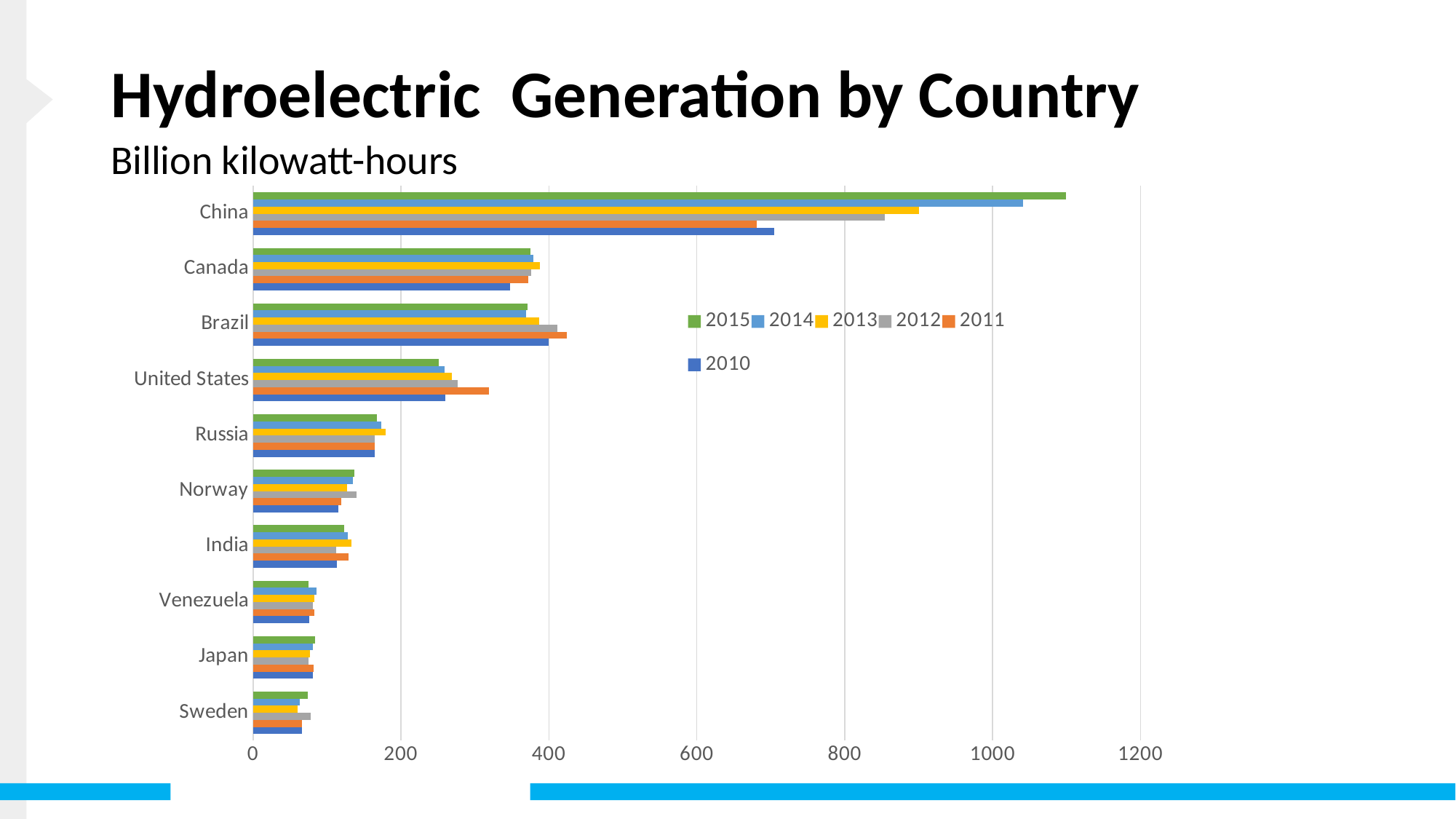
Is the value for Canada in 2015 greater or less than 400? less Which country has the highest hydroelectric generation in 2015? China How many countries are shown on the chart? 10 What kind of chart is shown on the slide? Bar chart How many series does the legend list? 6 Did China's hydroelectric generation rise or fall from 2010 to 2015? rise Which country has the lowest hydroelectric generation in 2013? Sweden Which is larger in 2011, the value for Brazil or the value for Canada? Brazil Is the value for China in 2015 greater or less than 1000? greater What unit is given below the chart title? Billion kilowatt-hours Is the value for Russia in 2013 greater or less than 200? less